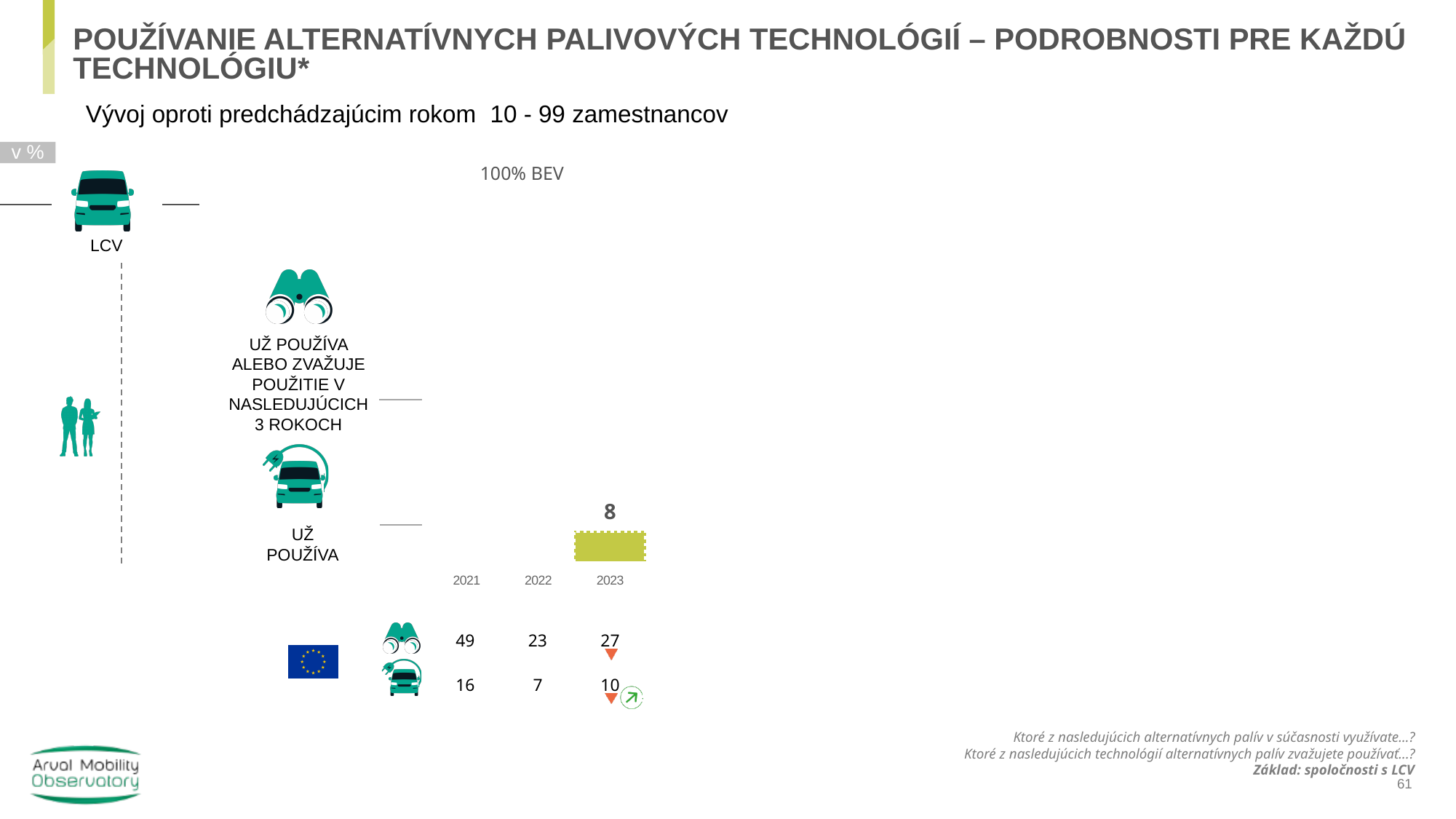
Which alternative fuel technology does the chart on this slide cover? 100% BEV In the EU reference row for 'už používa alebo zvažuje použitie', what is the difference between the 2021 and 2022 values? 26 In the EU reference row for 'už používa alebo zvažuje použitie', what is the value for 2021? 49 Which vehicle type does the chart on this slide refer to? LCV In the EU reference row for 'už používa', which year has the highest value? 2021 How many years are shown on the x axis of the 100% BEV chart? 3 What kind of chart is used to show the 'UŽ POUŽÍVA' value for 100% BEV? bar chart What is the value of the 2023 bar in the 'UŽ POUŽÍVA' row of the 100% BEV chart? 8 For 2023, which is larger: the EU 'už používa' value or the chart's 'UŽ POUŽÍVA' value for 10-99 employees? EU value (10) In the EU reference row for 'už používa', what is the difference between the 2021 and 2022 values? 9 In the EU reference row for 'už používa alebo zvažuje použitie', does the value rise or fall from 2022 to 2023? rise In the EU reference row for 'už používa', what is the value for 2023? 10